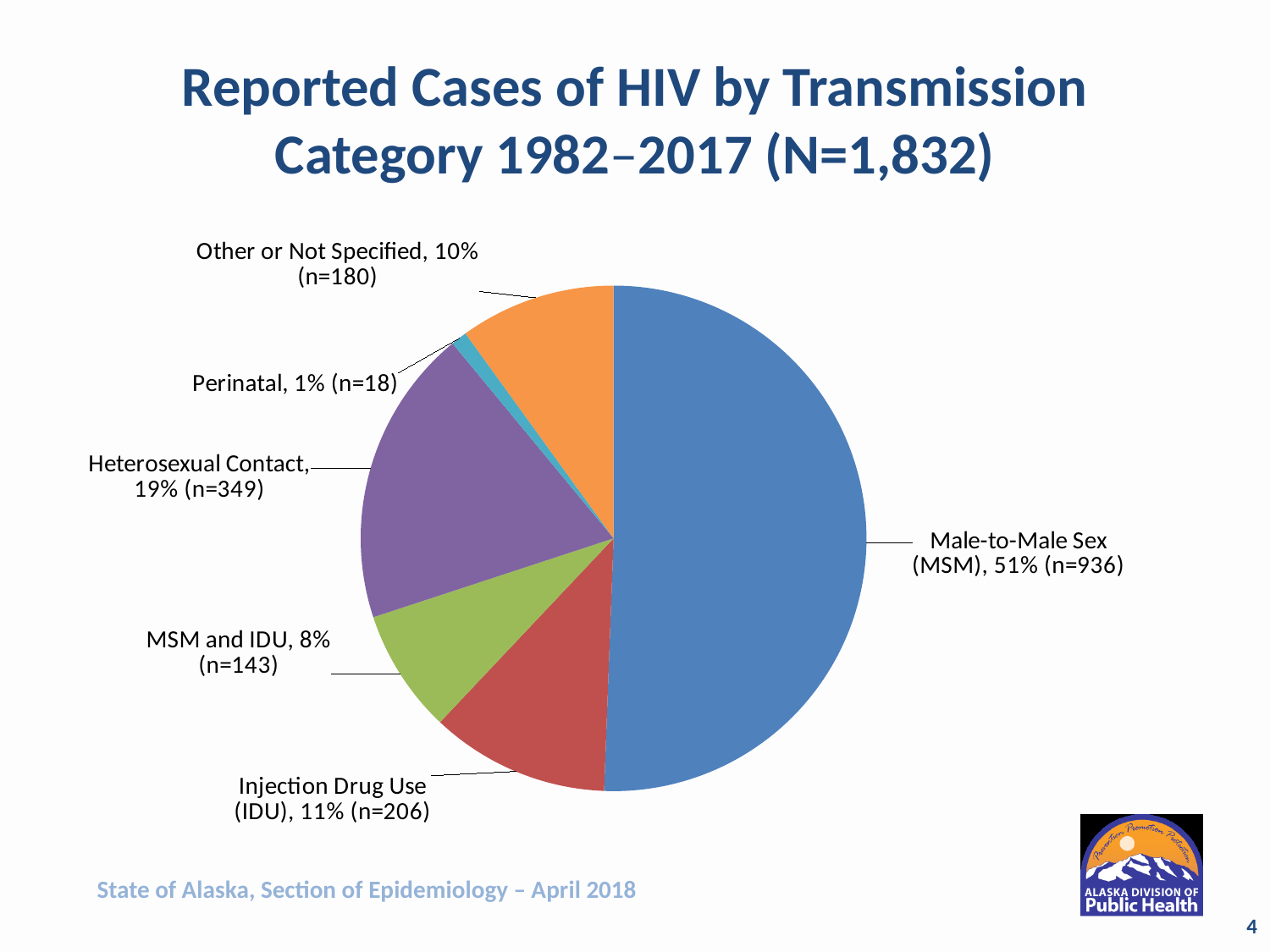
What percentage of reported HIV cases is attributed to Male-to-Male Sex (MSM)? 51% Which transmission category has the largest share of reported cases? Male-to-Male Sex (MSM) Which transmission category has the smallest share of reported cases? Perinatal How many transmission categories are shown in the pie chart? 6 What kind of chart is shown on the slide? pie chart What share of the pie does the Other or Not Specified slice represent? 10% How many reported HIV cases are attributed to Heterosexual Contact? 349 What is the total number of reported cases (N) stated in the chart title? 1,832 Which has more reported cases: MSM and IDU or Other or Not Specified? Other or Not Specified What percentage of cases is attributed to Injection Drug Use (IDU)? 11% How many cases are in the Perinatal category? 18 What is the difference in number of cases between Heterosexual Contact and Injection Drug Use (IDU)? 143